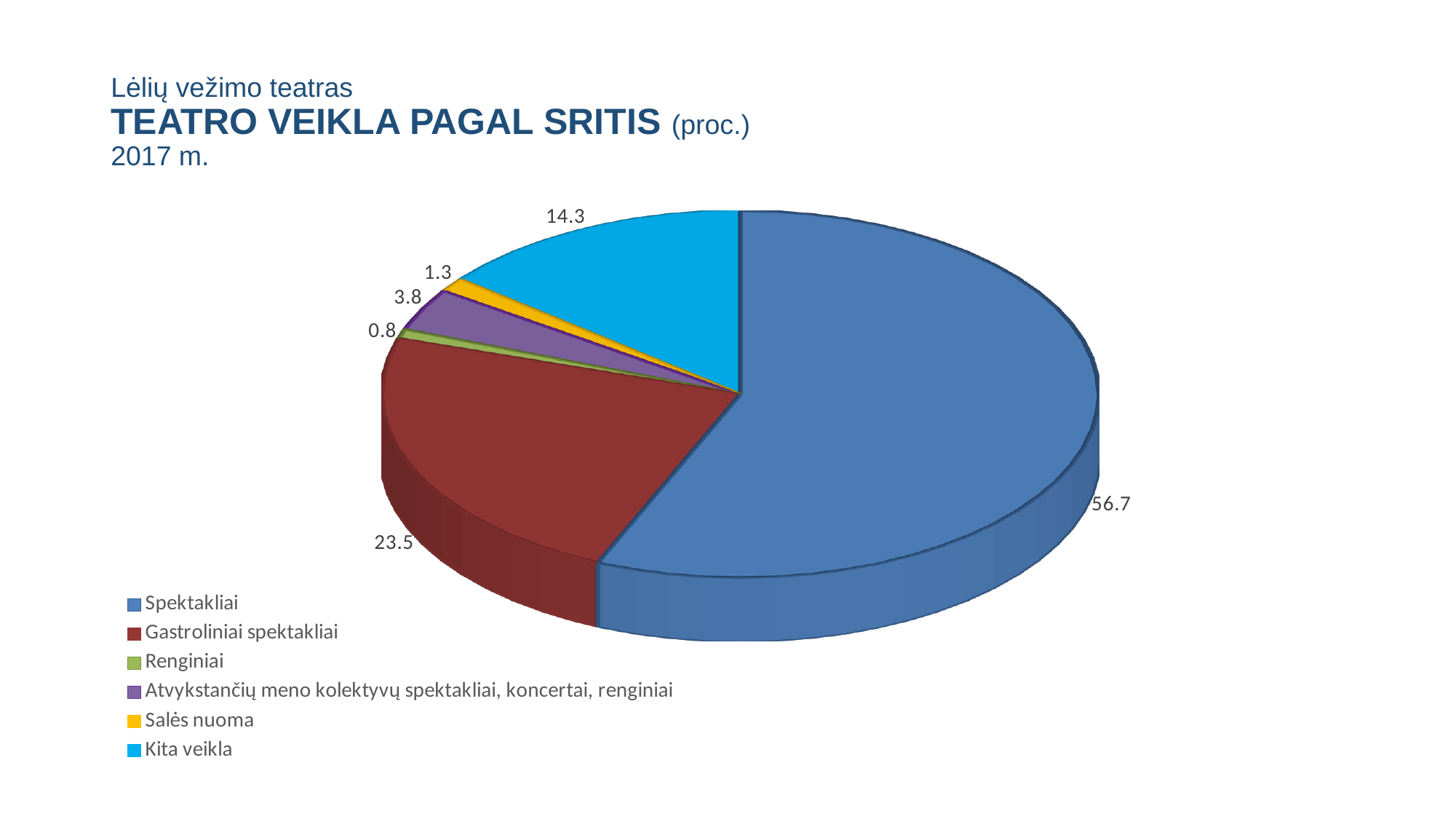
What is the value for Kita veikla? 14.3 How many categories does the legend list? 6 What is the value for Salės nuoma? 1.3 Which category has the largest slice? Spektakliai What is the difference between the values for Spektakliai and Gastroliniai spektakliai? 33.2 What is the value for Renginiai? 0.8 Which is larger, Kita veikla or Atvykstančių meno kolektyvų spektakliai, koncertai, renginiai? Kita veikla What is the value for Spektakliai? 56.7 Which category has the smallest slice? Renginiai Which year does the chart title refer to? 2017 m. What is the value for Gastroliniai spektakliai? 23.5 What kind of chart is shown on the slide? pie chart